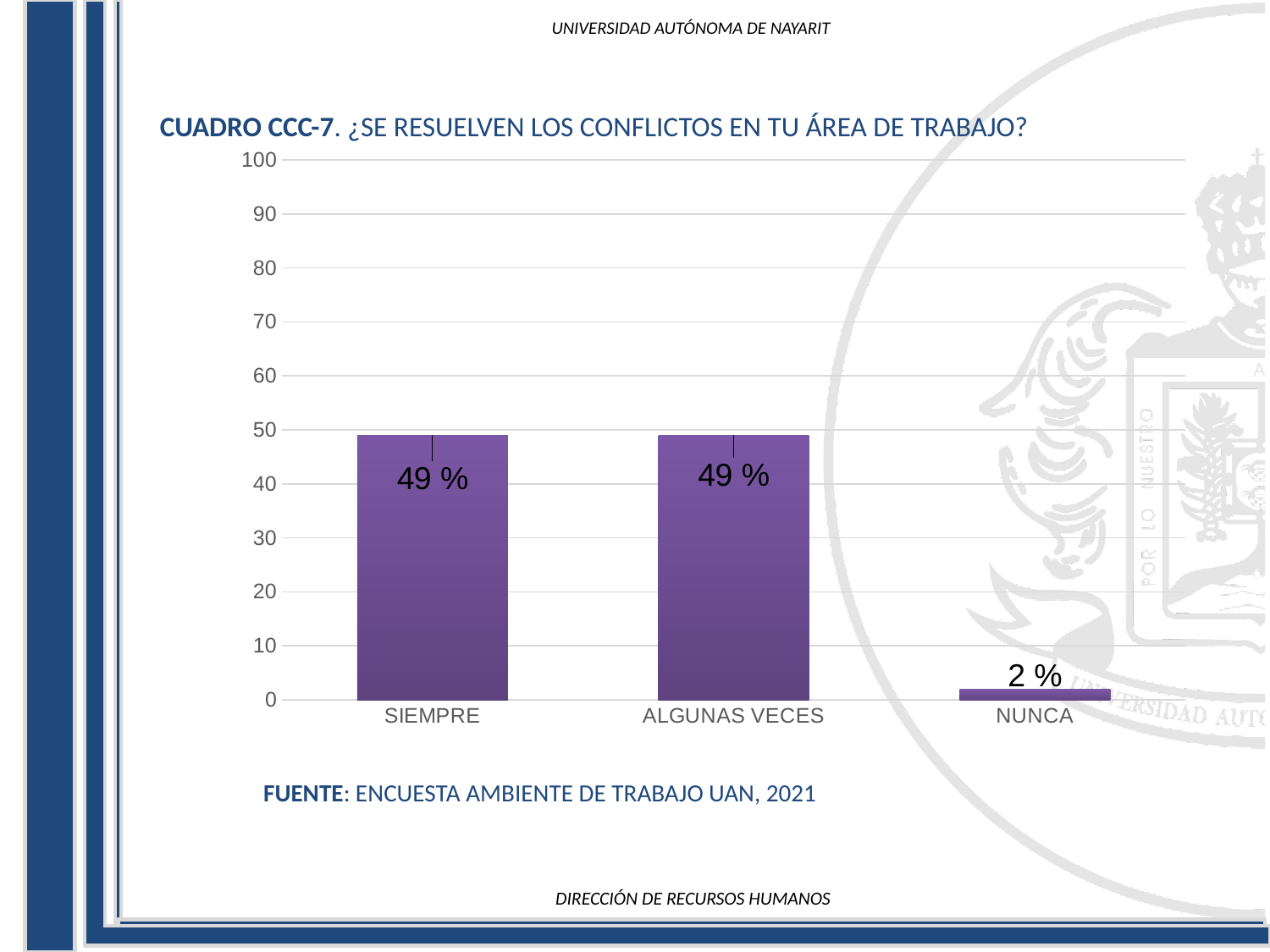
Which category has the lowest value? NUNCA What is the value for ALGUNAS VECES? 49 % Which is larger, the value for ALGUNAS VECES or the value for NUNCA? ALGUNAS VECES What is the value for SIEMPRE? 49 % Is the value for NUNCA greater or less than 10? less How many categories are shown on the x axis? 3 What is the difference between the values for SIEMPRE and NUNCA? 47 % What is the value for NUNCA? 2 % What is the source cited below the chart? ENCUESTA AMBIENTE DE TRABAJO UAN, 2021 What is the total of the values for SIEMPRE and ALGUNAS VECES? 98 % What kind of chart is shown on the slide? bar chart Is the value for SIEMPRE greater or less than 40? greater